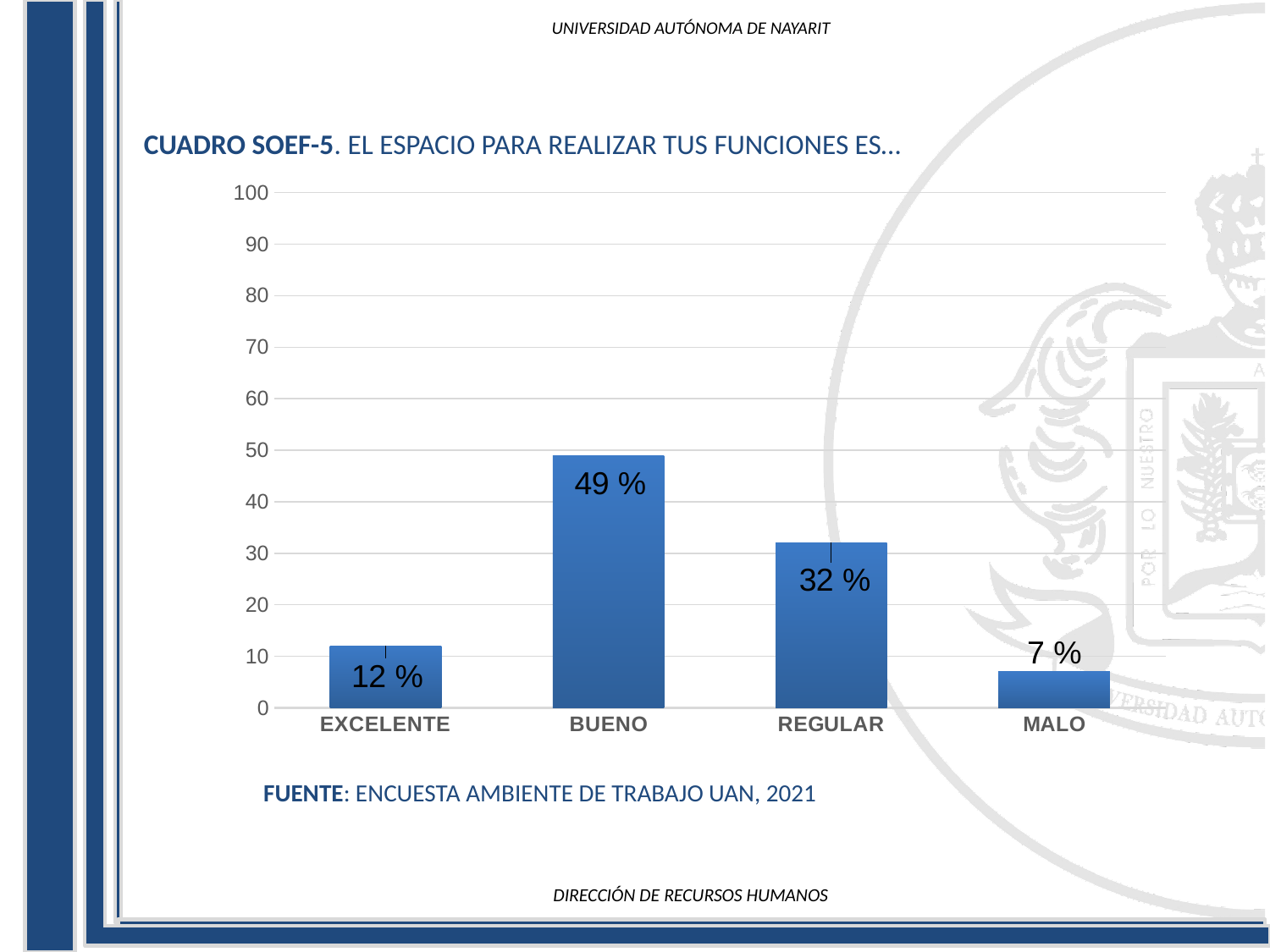
How many categories are shown on the x axis? 4 What kind of chart is shown on the slide? bar chart Which category has the highest value? BUENO What is the value for REGULAR? 32 % Which category has the lowest value? MALO Which is larger, the value for EXCELENTE or the value for REGULAR? REGULAR What is the value for MALO? 7 % What is the difference between the values for BUENO and REGULAR? 17 % What is the title of the chart? CUADRO SOEF-5. EL ESPACIO PARA REALIZAR TUS FUNCIONES ES… What is the value for EXCELENTE? 12 % What is the value for BUENO? 49 % Is the value for BUENO greater or less than 40? greater